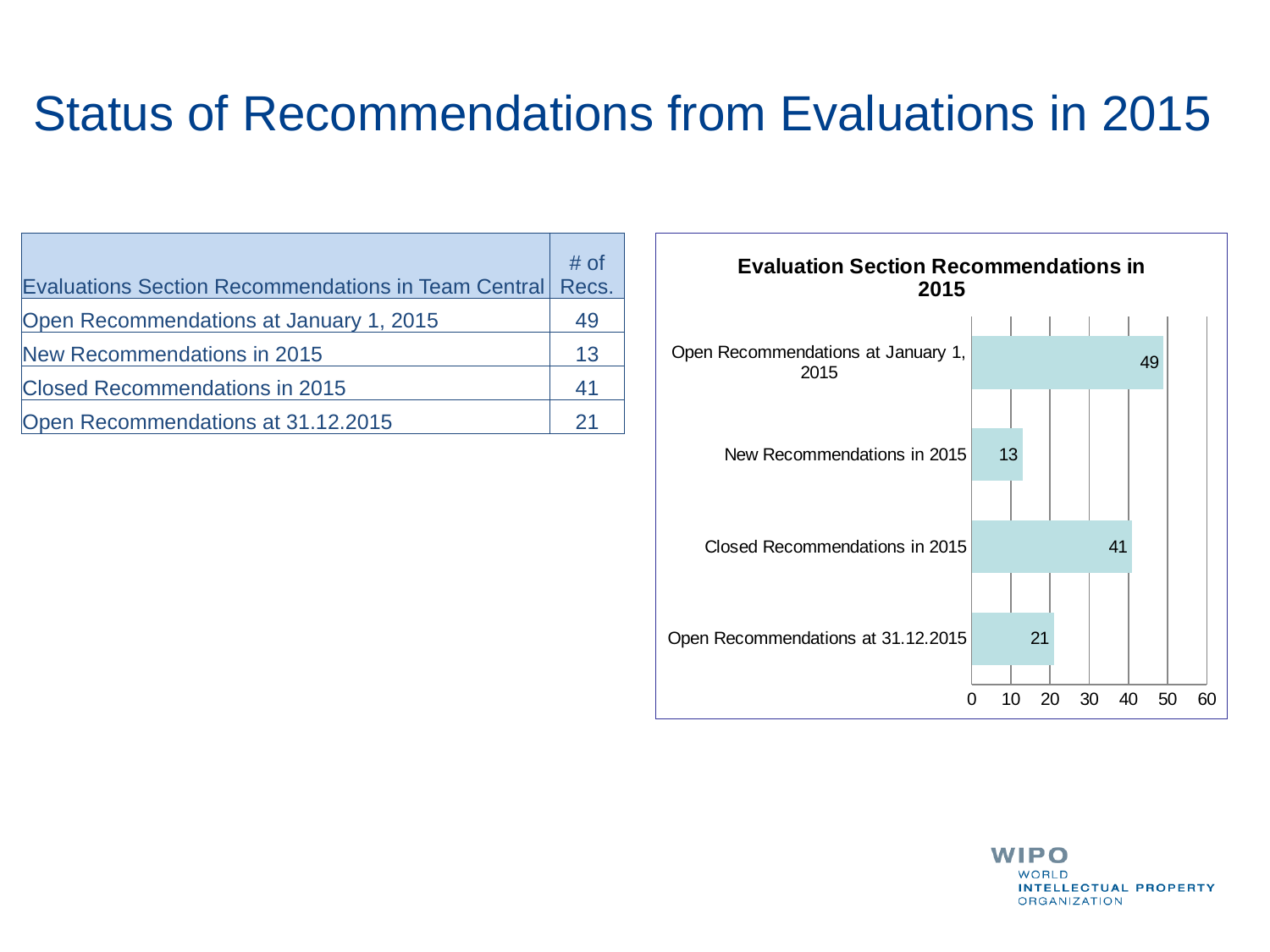
Which category has the lowest value? New Recommendations in 2015 What kind of chart is shown on the slide? bar chart How many categories are shown in the chart? 4 What is the value for Open Recommendations at 31.12.2015? 21 What is the value for Closed Recommendations in 2015? 41 What is the title of the chart? Evaluation Section Recommendations in 2015 Is the value for Closed Recommendations in 2015 greater or less than 30? greater What is the value for Open Recommendations at January 1, 2015? 49 Which is larger: Closed Recommendations in 2015 or Open Recommendations at 31.12.2015? Closed Recommendations in 2015 What is the difference between Open Recommendations at January 1, 2015 and Open Recommendations at 31.12.2015? 28 What is the value for New Recommendations in 2015? 13 Which category has the highest value? Open Recommendations at January 1, 2015